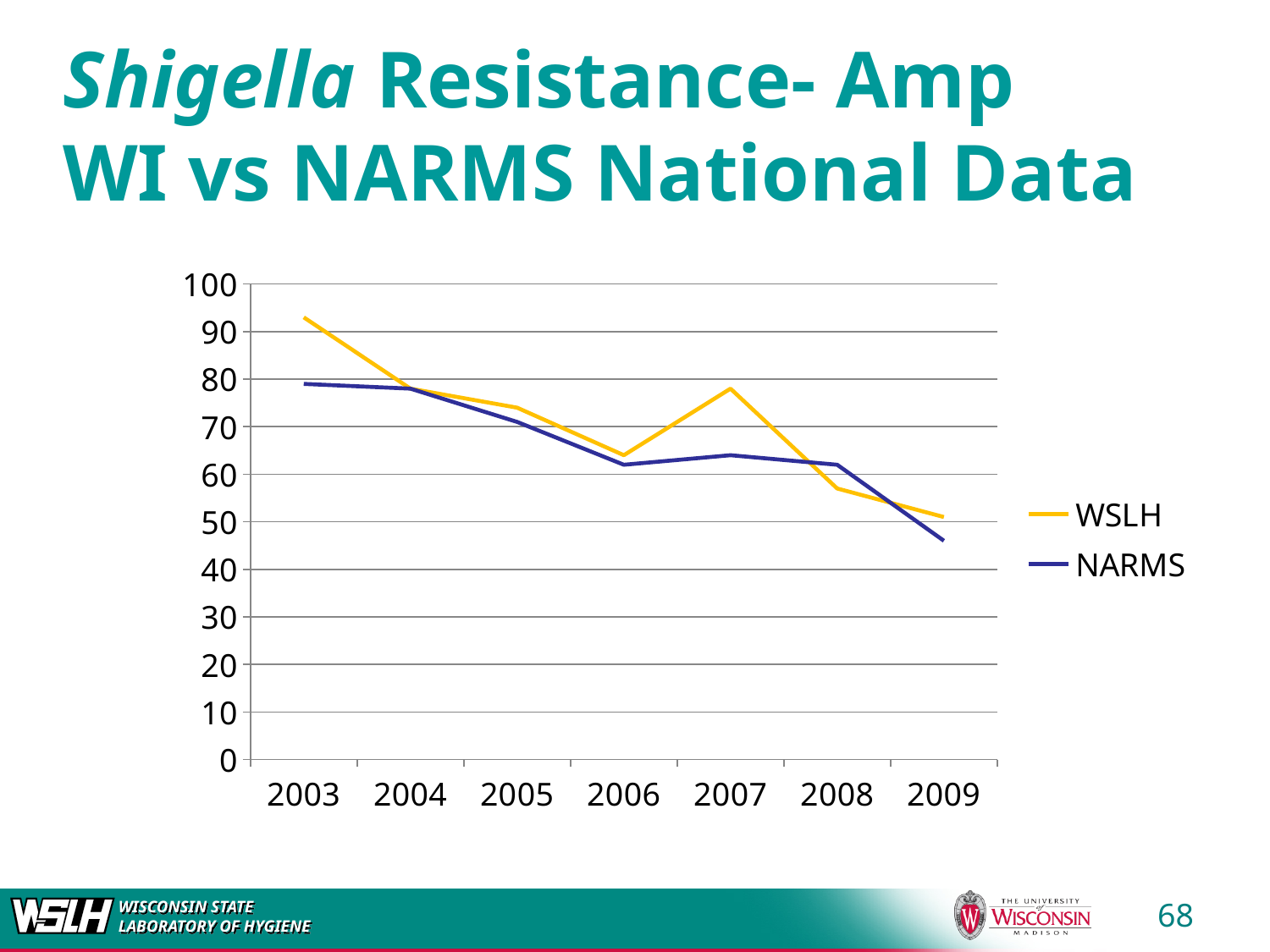
How many series does the legend list? 2 Is the NARMS value for 2009 greater or less than 50? less In 2007, which series has the higher value, WSLH or NARMS? WSLH Is the WSLH value for 2003 greater or less than 90? greater What kind of chart is shown on the slide? line chart Is the WSLH value for 2007 greater or less than 70? greater How many years are shown on the x axis? 7 In which year is the WSLH value highest? 2003 In which year is the NARMS value lowest? 2009 Overall, do the NARMS values rise or fall from 2003 to 2009? fall In 2003, which series has the higher value, WSLH or NARMS? WSLH